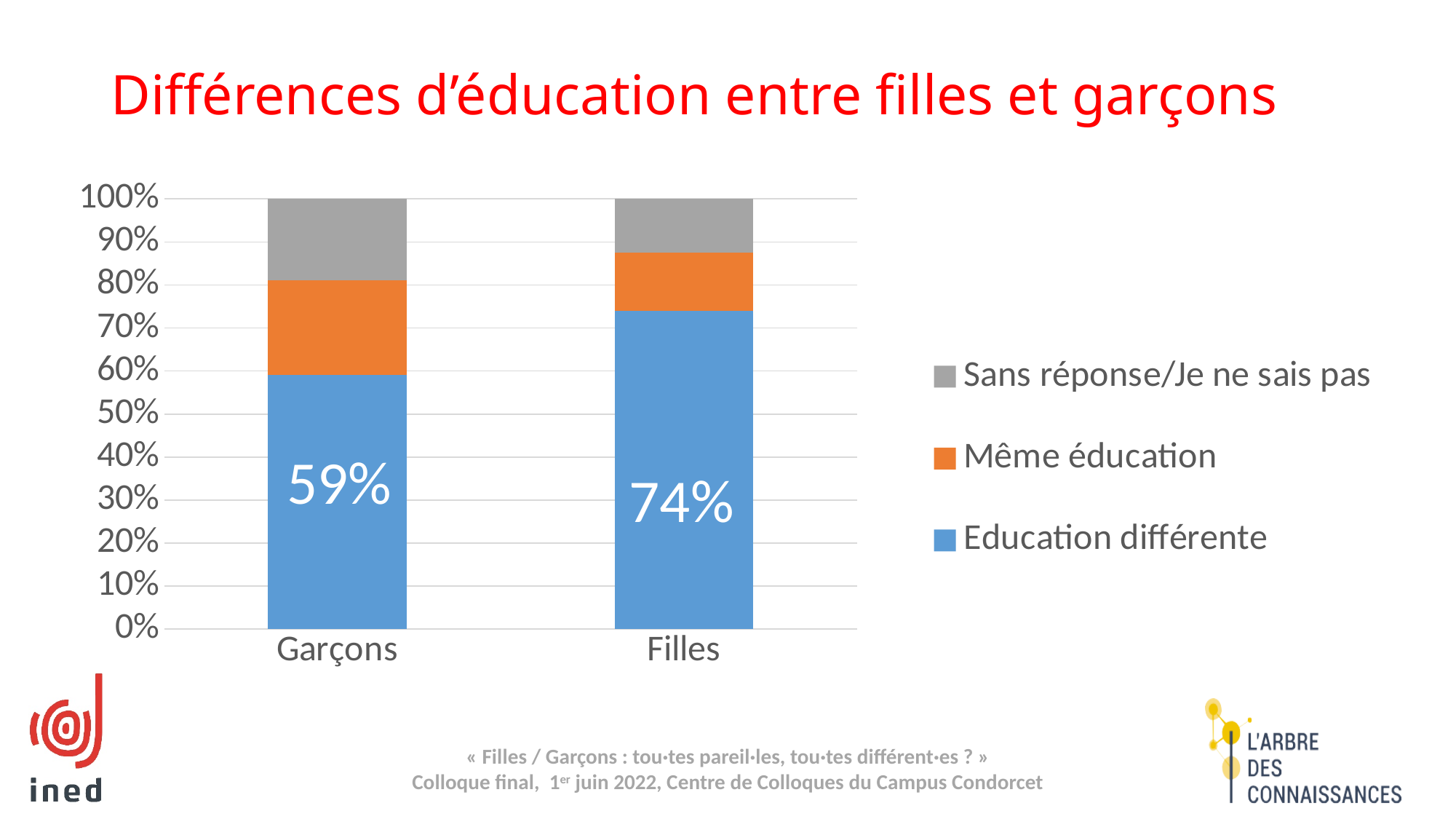
Which colour represents Education différente in the legend? Blue What kind of chart is shown on the slide? Stacked bar chart Which category has the highest value for Education différente? Filles What percentage of Filles is shown for Education différente? 74% Which group has the larger Education différente value, Garçons or Filles? Filles Is the Sans réponse/Je ne sais pas segment for Garçons greater or less than 10%? greater What is the total height of the stacked bar for Garçons? 100% How many series does the legend list? 3 What percentage of Garçons is shown for Education différente? 59% What is the difference between the Education différente values for Filles and Garçons? 15 percentage points How many categories are shown on the x axis of the chart? 2 Is the Même éducation segment for Filles greater or less than 20%? less